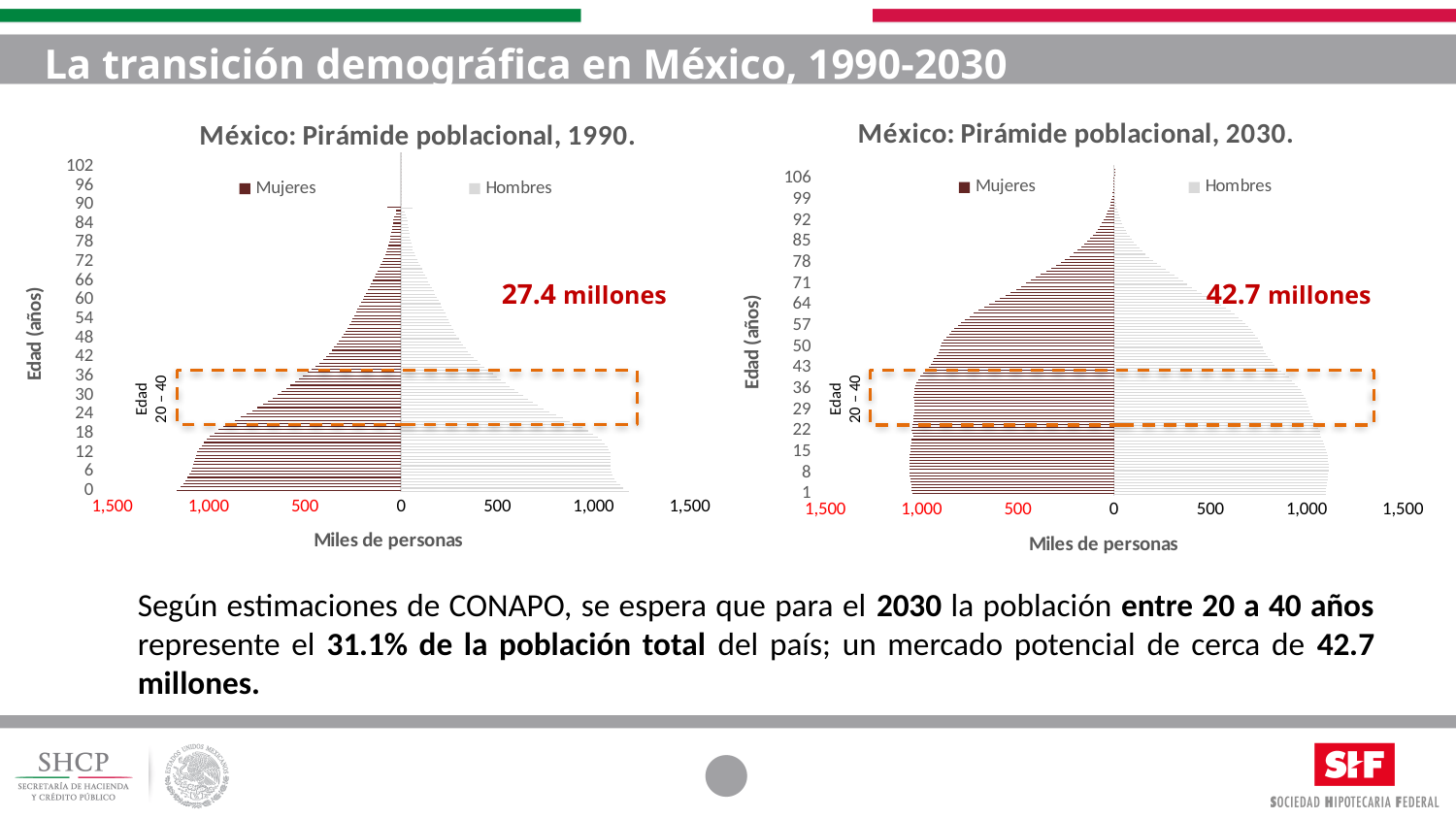
What kind of chart is the 'México: Pirámide poblacional, 1990.' chart? bar chart What are the two series named in the legend of the 'México: Pirámide poblacional, 1990.' chart? Mujeres and Hombres How many series does the legend of the 'México: Pirámide poblacional, 2030.' chart list? 2 Which chart shows the larger annotated figure, the 1990 pyramid (27.4 millones) or the 2030 pyramid (42.7 millones)? the 2030 pyramid What is the x-axis title of the 'México: Pirámide poblacional, 2030.' chart? Miles de personas What value is annotated in red on the 'México: Pirámide poblacional, 1990.' chart? 27.4 millones In the 'México: Pirámide poblacional, 1990.' chart, do the bar lengths for Hombres rise or fall as age increases from 0 to 102? fall In the 'México: Pirámide poblacional, 2030.' chart, is the value for Mujeres at age 92 greater or less than 500? less What value is annotated in red on the 'México: Pirámide poblacional, 2030.' chart? 42.7 millones In the 'México: Pirámide poblacional, 1990.' chart, is the value for Mujeres at age 60 greater or less than 500? less In the 'México: Pirámide poblacional, 1990.' chart, is the value for Hombres at age 0 greater or less than 1,000? greater